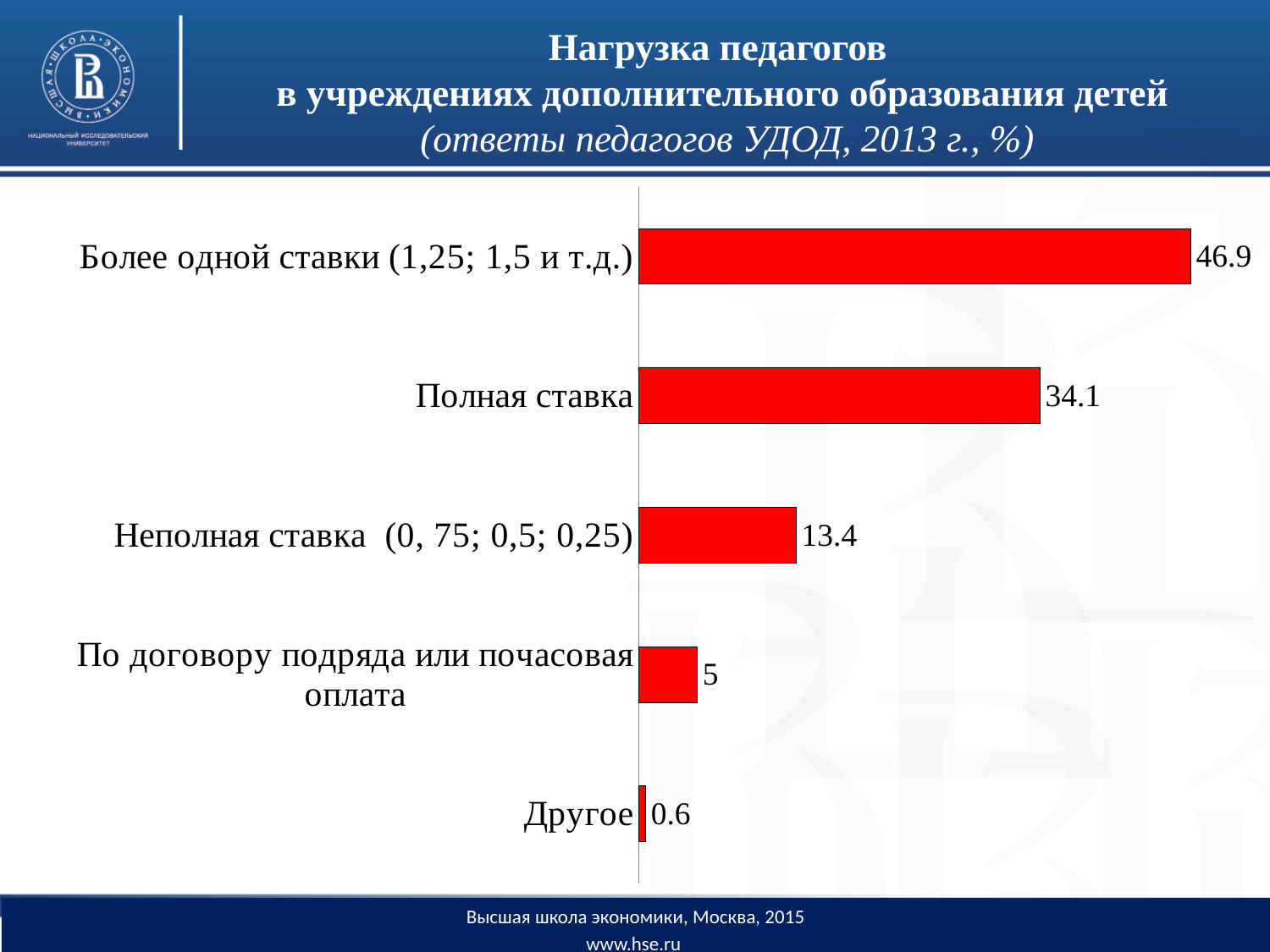
What is the value for "Другое"? 0.6 What is the difference between the values for "Неполная ставка (0, 75; 0,5; 0,25)" and "По договору подряда или почасовая оплата"? 8.4 What kind of chart is shown on the slide? Bar chart What is the difference between the values for "Более одной ставки (1,25; 1,5 и т.д.)" and "Полная ставка"? 12.8 What is the value for "Неполная ставка (0, 75; 0,5; 0,25)"? 13.4 Which category has the highest value? Более одной ставки (1,25; 1,5 и т.д.) What is the value for "Полная ставка"? 34.1 What is the value for "По договору подряда или почасовая оплата"? 5 What colour are the bars in the chart? Red Which is larger, the value for "Полная ставка" or the value for "Неполная ставка (0, 75; 0,5; 0,25)"? Полная ставка How many categories are shown in the chart? 5 Which category has the lowest value? Другое